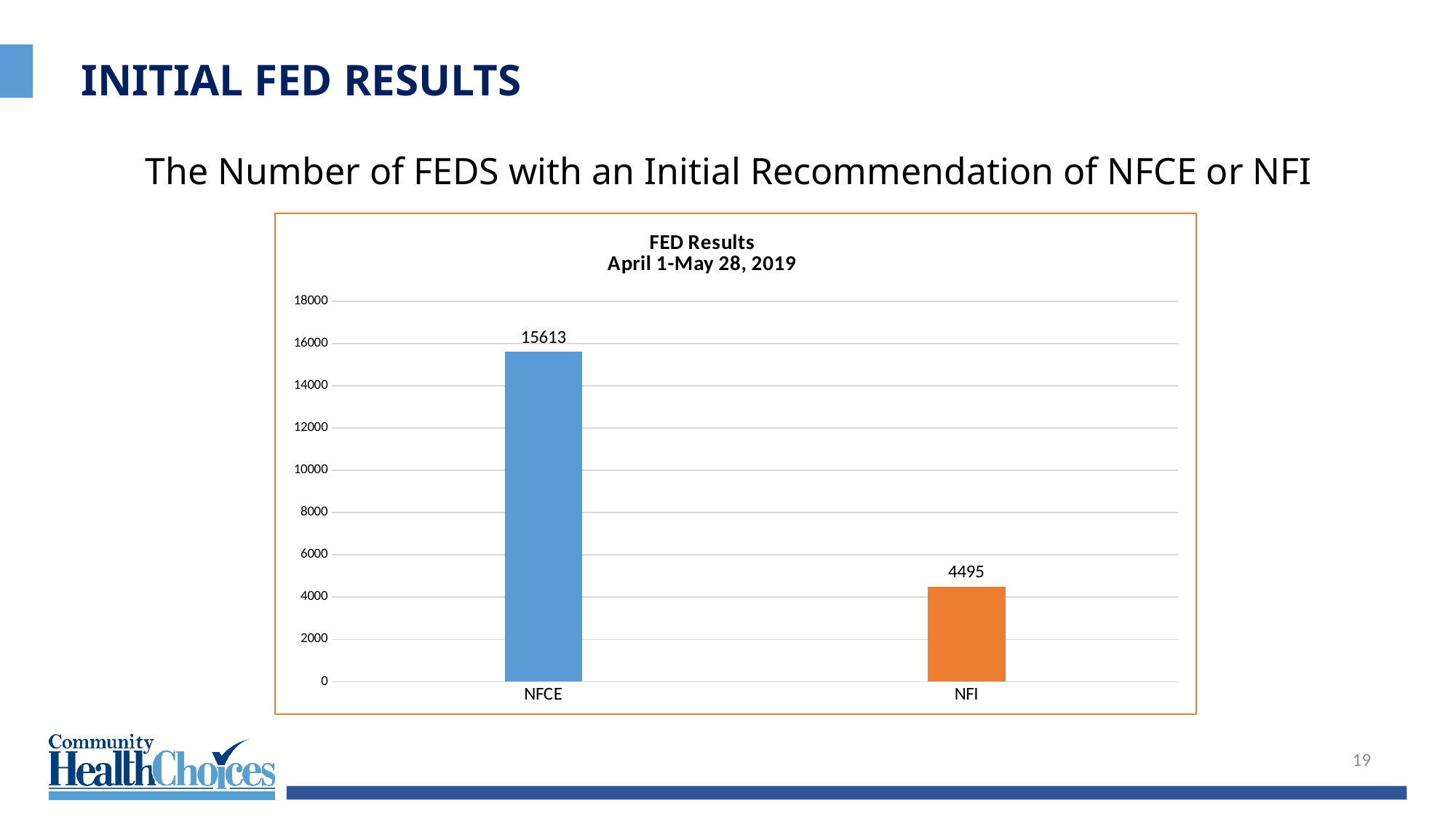
Which is larger, the value for NFCE or the value for NFI? NFCE Is the value for NFI greater or less than 6000? less What is the value for NFCE? 15613 What colour is the bar for NFI? orange Which category has the highest value? NFCE What is the difference between the values for NFCE and NFI? 11118 How many categories are shown in the chart? 2 What kind of chart is shown on the slide? bar chart Which category has the lowest value? NFI What is the value for NFI? 4495 What is the title of the chart? FED Results April 1-May 28, 2019 Is the value for NFCE greater or less than 14000? greater